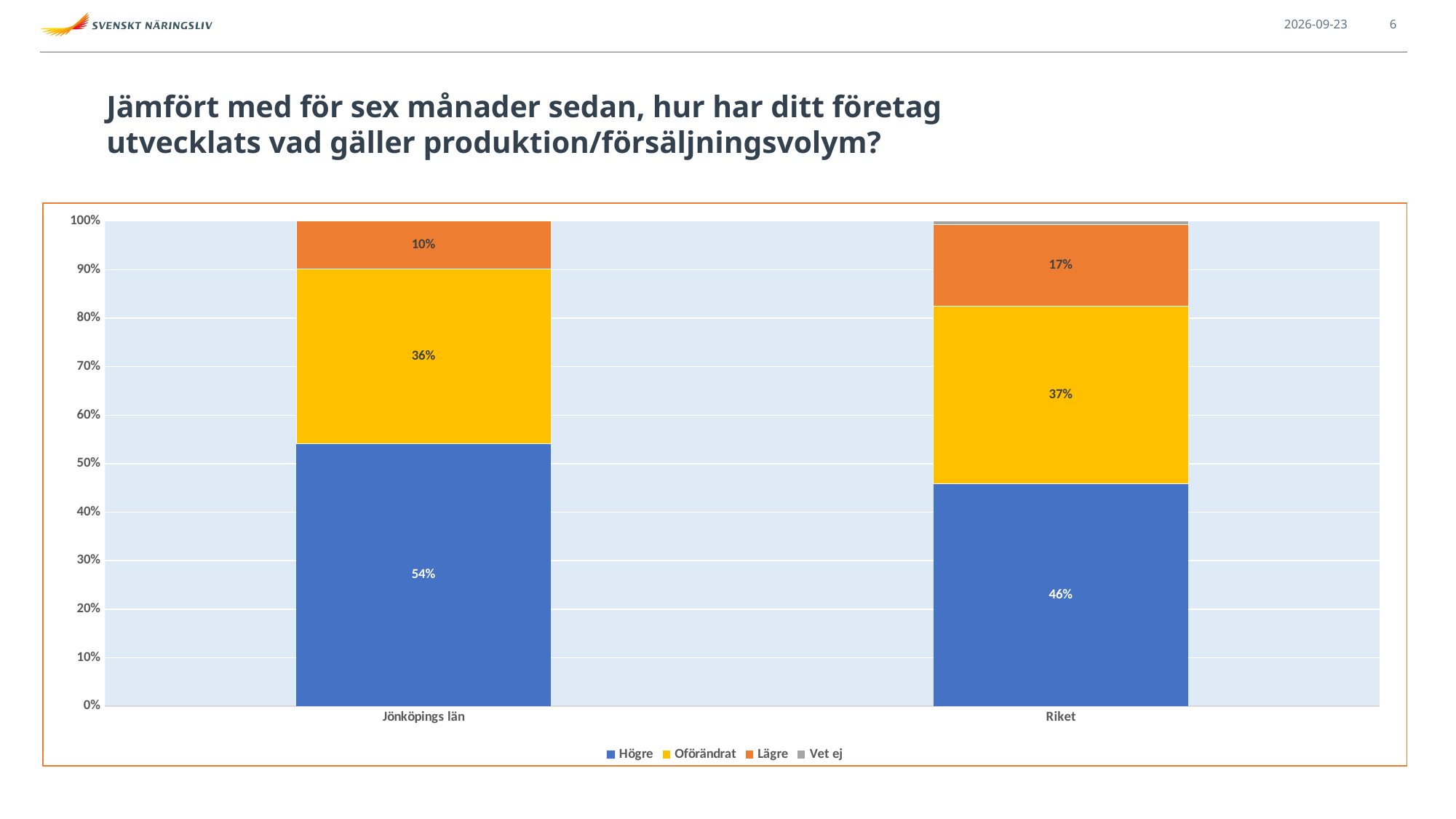
What is the value for Högre in Riket? 46% What is the difference between the Lägre values for Riket and Jönköpings län? 7% Which colour represents Oförändrat in the legend? Yellow What kind of chart is shown on the slide? Stacked bar chart What is the value for Lägre in Jönköpings län? 10% What is the value for Högre in Jönköpings län? 54% Which category has the higher value for Lägre, Jönköpings län or Riket? Riket How many categories are shown on the x axis? 2 What is the difference between the Högre values for Jönköpings län and Riket? 8% How many series does the legend list? 4 Which category has the highest value for Högre? Jönköpings län What is the value for Oförändrat in Riket? 37%